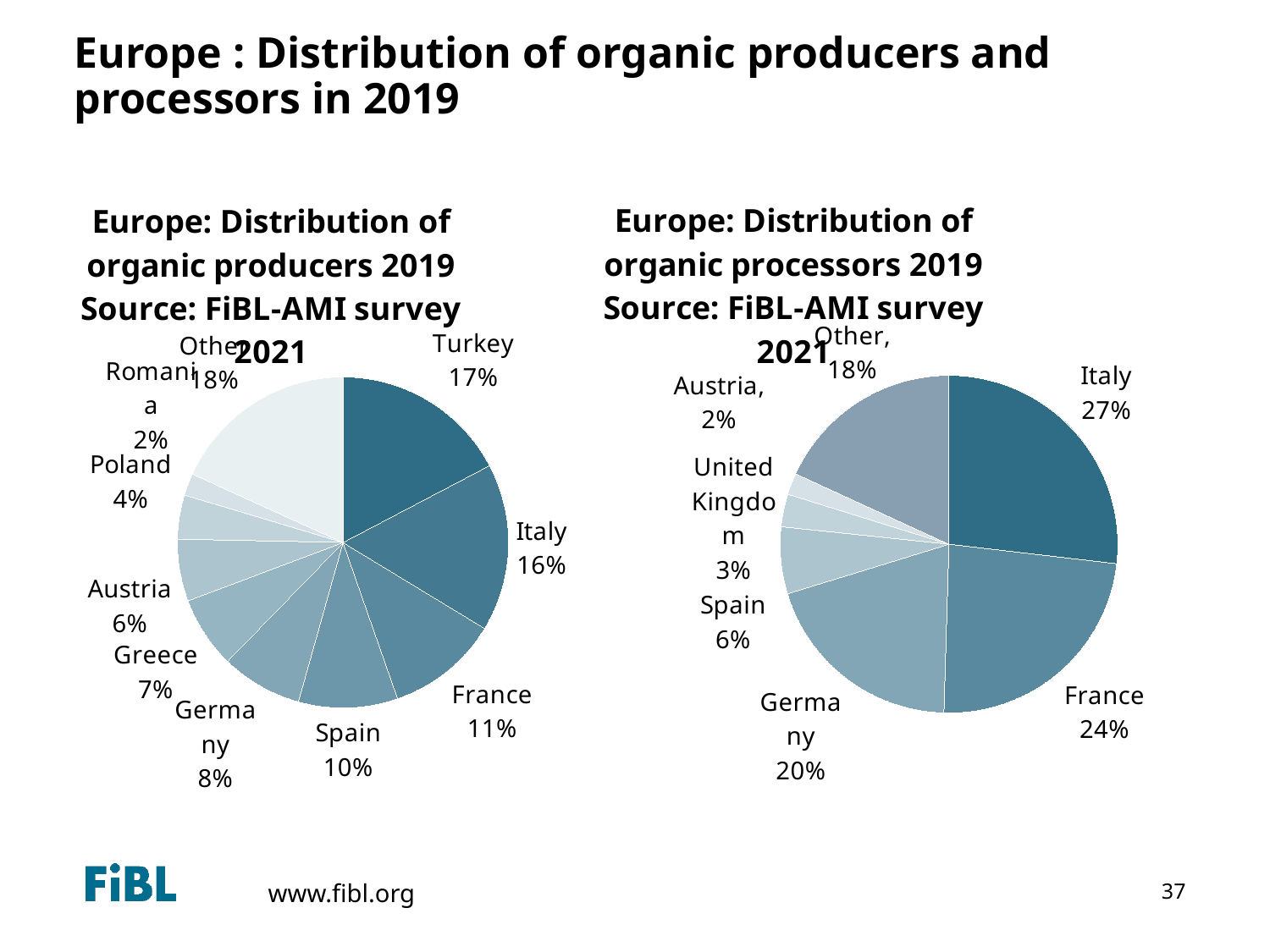
In the organic processors pie chart, what share does Germany have? 20% What type of chart is used for the distribution of organic processors? Pie chart In the organic producers pie chart, which country has the smallest share? Romania In the organic processors pie chart, which named country has the largest share? Italy In the organic producers pie chart, what share does Turkey have? 17% In the organic processors pie chart, which country has the smallest share? Austria How many slices does the organic processors pie chart have? 7 In the organic producers pie chart, what share does Spain have? 10% How many slices does the organic producers pie chart have? 10 What is the source named in the title of the organic producers chart? FiBL-AMI survey 2021 In the organic producers pie chart, which is larger, the share for Italy or the share for France? Italy In the organic processors pie chart, what is the difference between Italy's share and France's share? 3%